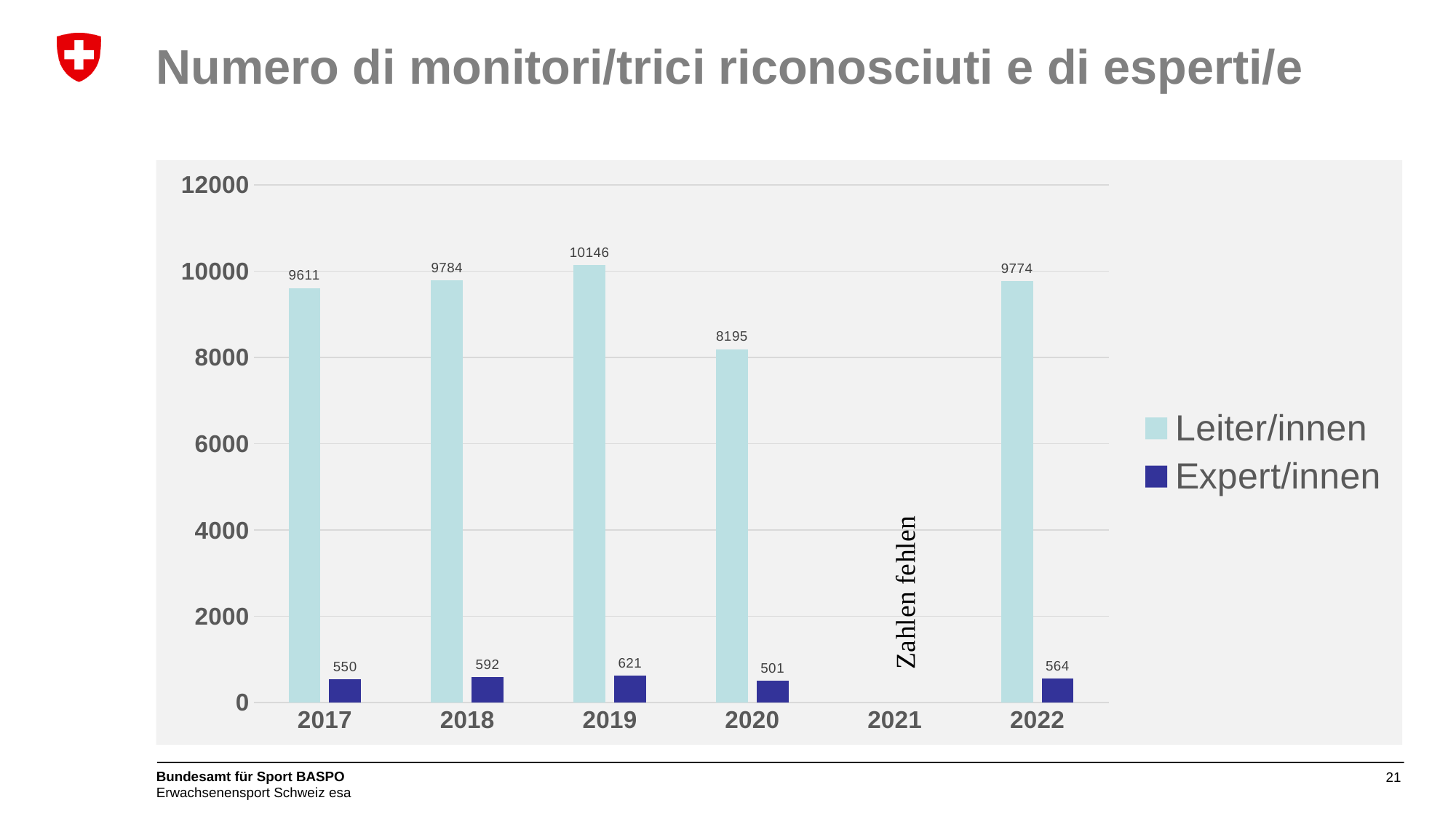
What is the value for Leiter/innen in 2022? 9774 Which is larger, the Expert/innen value for 2018 or for 2022? 2018 Which year has the highest value for Leiter/innen? 2019 What is the value for Leiter/innen in 2019? 10146 Which year has the lowest value for Expert/innen among the years with data? 2020 How many years are shown on the x axis? 6 What is the difference between the Leiter/innen values for 2019 and 2020? 1951 What is the value for Expert/innen in 2020? 501 What text is shown in place of the bars for 2021? Zahlen fehlen Is the value for Leiter/innen in 2020 greater or less than 10000? less How many series does the legend list? 2 What kind of chart is shown on the slide? bar chart